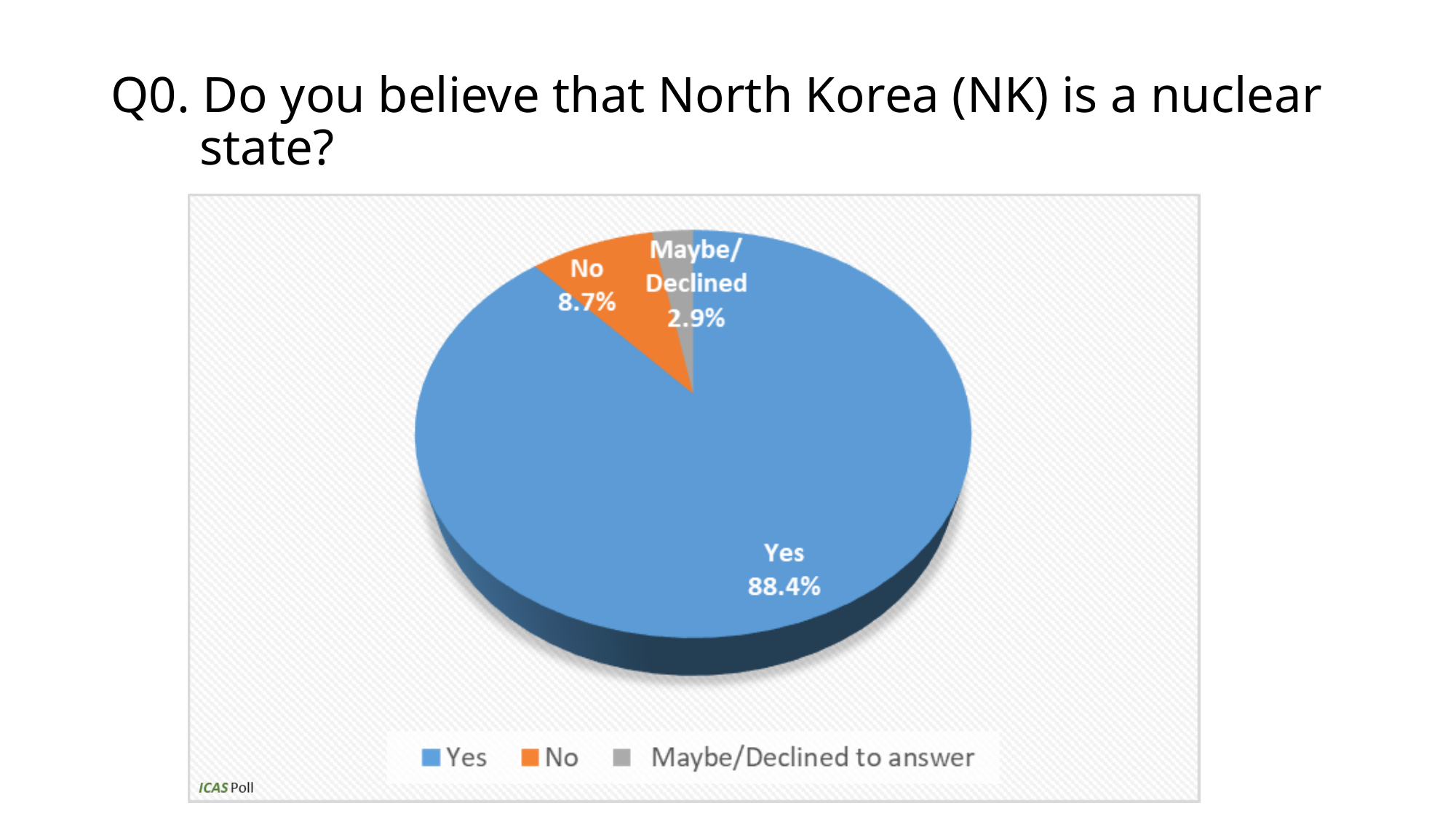
What colour is the Yes slice? blue Which response has the smallest share of the pie? Maybe/Declined to answer How many entries does the legend list? 3 Which response has the largest share of the pie? Yes What percentage of respondents answered Yes? 88.4% What is the difference in percentage points between the No and Maybe/Declined shares? 5.8 What kind of chart is shown on the slide? pie chart Which is larger, the No share or the Maybe/Declined share? No What percentage of respondents answered Maybe/Declined to answer? 2.9% What is the difference in percentage points between the Yes and No shares? 79.7 How many slices does the pie chart have? 3 What percentage of respondents answered No? 8.7%